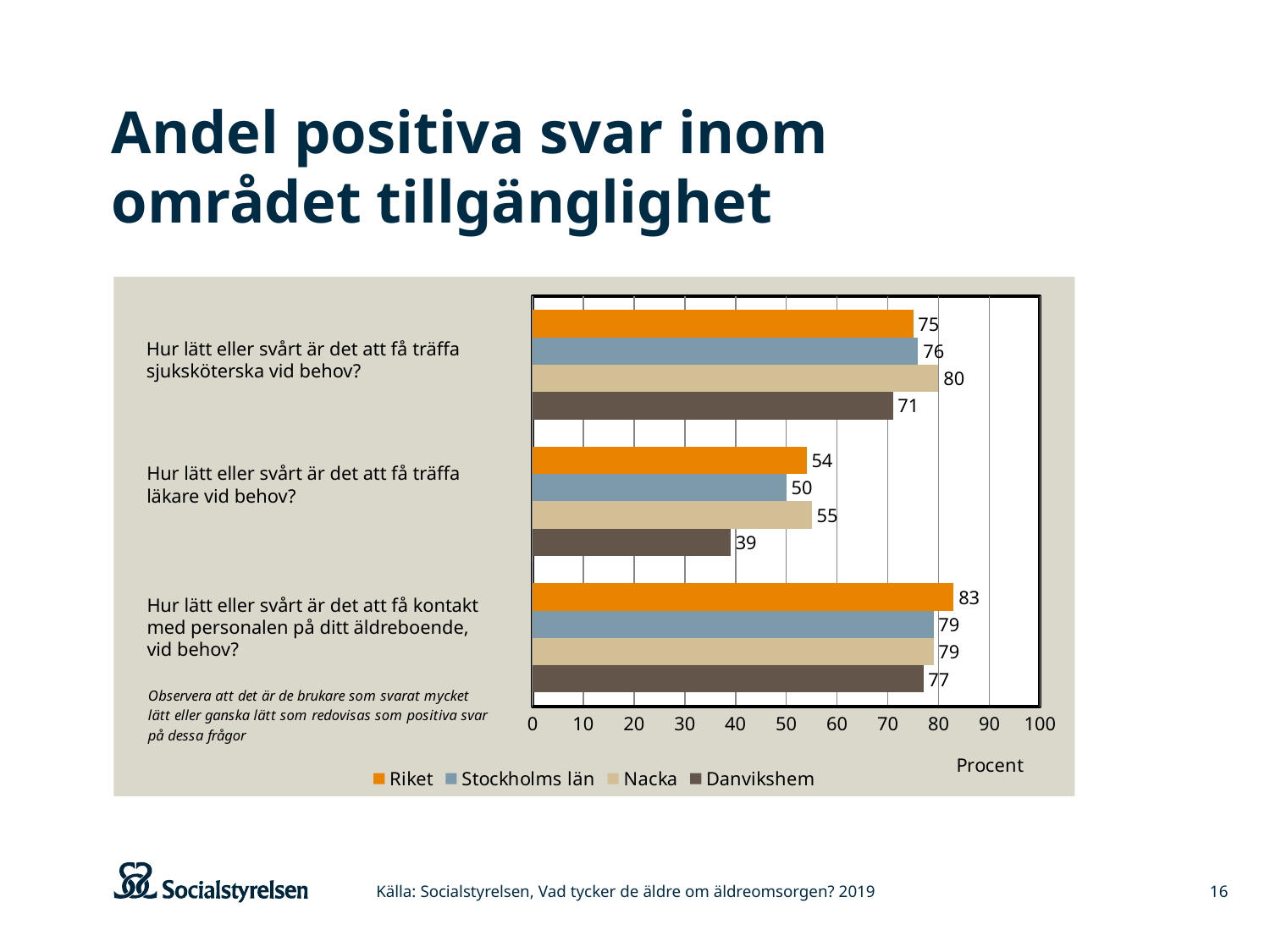
Which series has the highest value on the question "Hur lätt eller svårt är det att få träffa sjuksköterska vid behov?"? Nacka How many series does the legend list? 4 What is the difference between the Stockholms län and Danvikshem values on the question "Hur lätt eller svårt är det att få träffa sjuksköterska vid behov?"? 5 What is the value for Riket on the question "Hur lätt eller svårt är det att få kontakt med personalen på ditt äldreboende, vid behov?"? 83 Which series has the lowest value on the question "Hur lätt eller svårt är det att få träffa läkare vid behov?"? Danvikshem What is the value for Danvikshem on the question "Hur lätt eller svårt är det att få träffa läkare vid behov?"? 39 What kind of chart is shown on the slide? Bar chart Which is larger on the question "Hur lätt eller svårt är det att få kontakt med personalen på ditt äldreboende, vid behov?": Riket or Danvikshem? Riket What is the label on the horizontal axis of the chart? Procent What is the difference between the Riket and Danvikshem values on the question "Hur lätt eller svårt är det att få träffa läkare vid behov?"? 15 How many questions (categories) are shown on the chart? 3 What is the value for Nacka on the question "Hur lätt eller svårt är det att få träffa sjuksköterska vid behov?"? 80